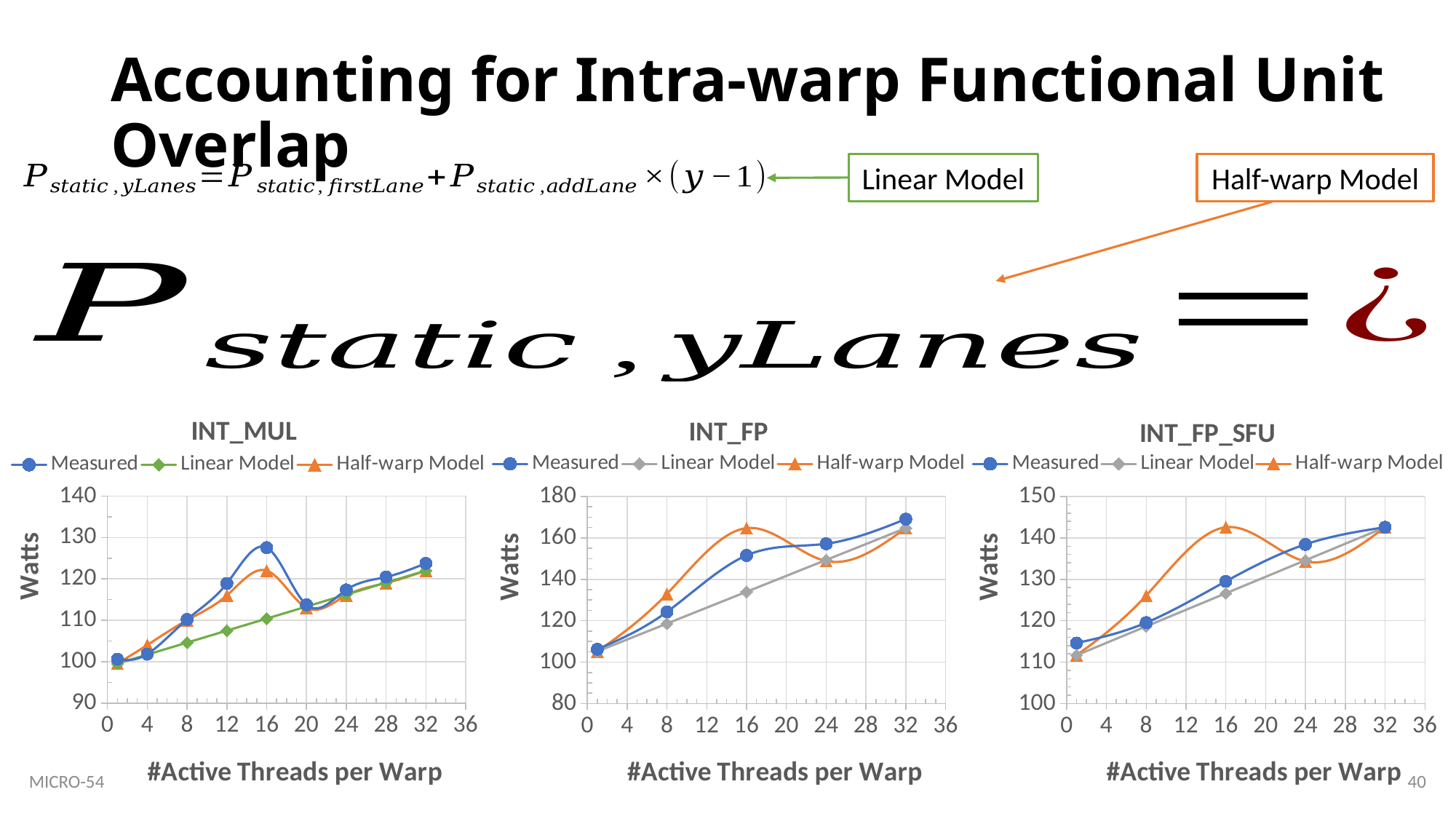
In the INT_MUL chart, is the Measured value at 16 active threads per warp greater or less than 120? greater In the INT_MUL chart, at 16 active threads per warp, which is larger: the Measured value or the Linear Model value? Measured In the INT_MUL chart, at which number of active threads per warp is the Measured series highest? 16 In the INT_MUL chart, how many data points does the Measured series have? 9 In the INT_FP_SFU chart, is the Half-warp Model value at 16 active threads per warp greater or less than 140? greater In the INT_FP chart, does the Linear Model series rise or fall as the number of active threads per warp increases? rise In the INT_FP_SFU chart, at which number of active threads per warp is the Measured series highest? 32 How many series does the legend of the INT_FP chart list? 3 What kind of chart is the INT_MUL chart? line chart In the INT_FP chart, how many data points does the Measured series have? 5 In the INT_FP chart, is the Half-warp Model value at 16 active threads per warp greater or less than 160? greater